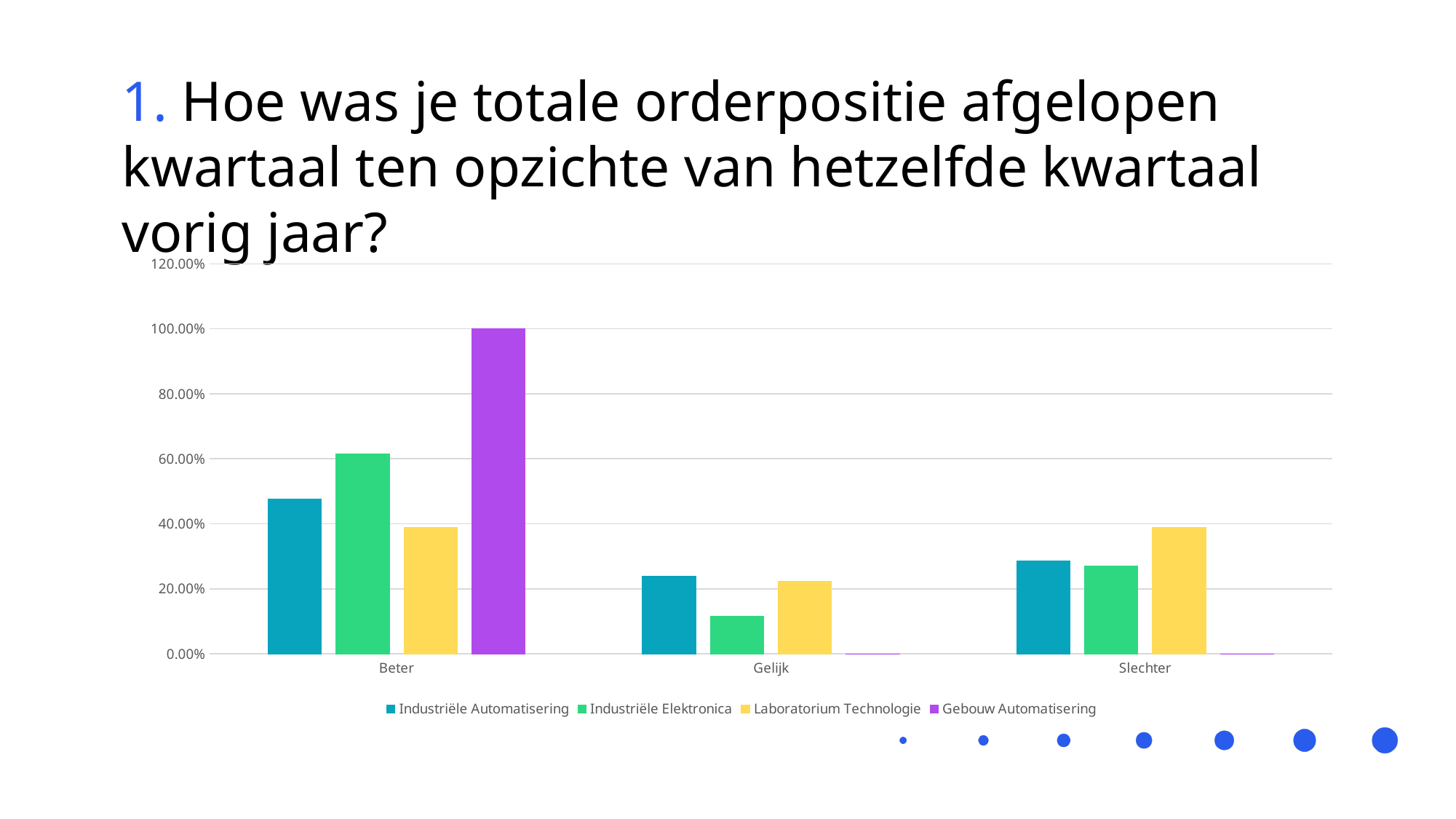
Is the value for Industriële Automatisering in the Beter category greater or less than 40.00%? greater Is the value for Industriële Elektronica in the Gelijk category greater or less than 20.00%? less What is the value for Gebouw Automatisering in the Beter category? 100.00% In which category does Gebouw Automatisering have its highest value? Beter What colour represents Gebouw Automatisering in the chart? purple Which series has the lowest value in the Gelijk category? Gebouw Automatisering What kind of chart is shown on the slide? bar chart In the Beter category, which is larger: Industriële Elektronica or Industriële Automatisering? Industriële Elektronica How many series does the chart's legend list? 4 Which series has the highest value in the Beter category? Gebouw Automatisering Which series has the highest value in the Slechter category? Laboratorium Technologie How many categories are shown on the x axis of the chart? 3